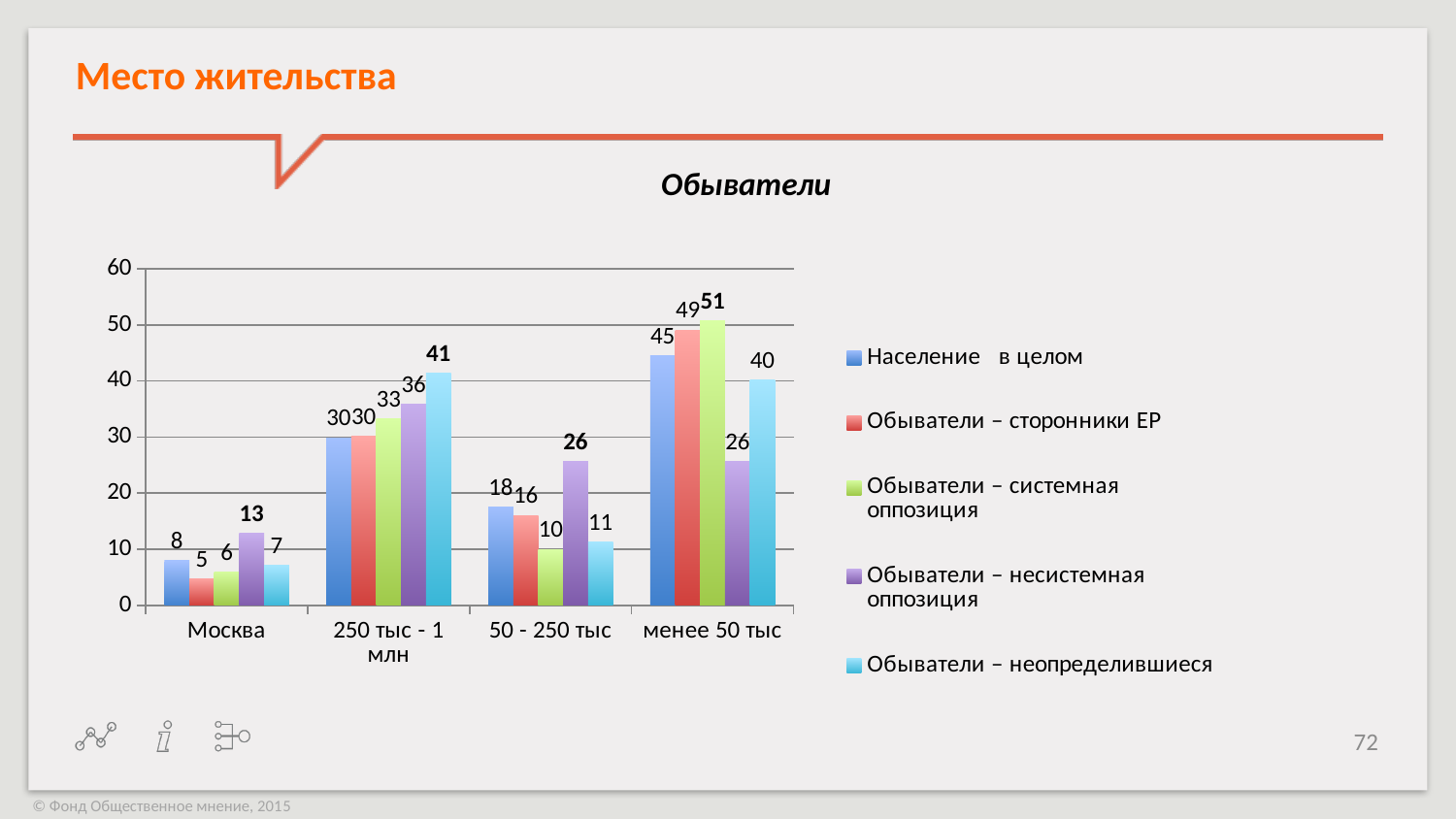
How many categories are shown on the x axis? 4 What is the difference between "Обыватели – системная оппозиция" and "Обыватели – несистемная оппозиция" in the "менее 50 тыс" category? 25 Which series has the lowest value in the "Москва" category? Обыватели – сторонники ЕР What is the value for "Обыватели – неопределившиеся" in the "250 тыс - 1 млн" category? 41 Which series has the highest value in the "50 - 250 тыс" category? Обыватели – несистемная оппозиция What is the value for "Население в целом" in the "50 - 250 тыс" category? 18 Which is larger in the "250 тыс - 1 млн" category: "Обыватели – системная оппозиция" or "Обыватели – несистемная оппозиция"? Обыватели – несистемная оппозиция What is the value for "Обыватели – несистемная оппозиция" in the "Москва" category? 13 What is the value for "Обыватели – системная оппозиция" in the "менее 50 тыс" category? 51 What is the title shown above the chart? Обыватели What kind of chart is shown on the slide? Bar chart How many series does the legend list? 5